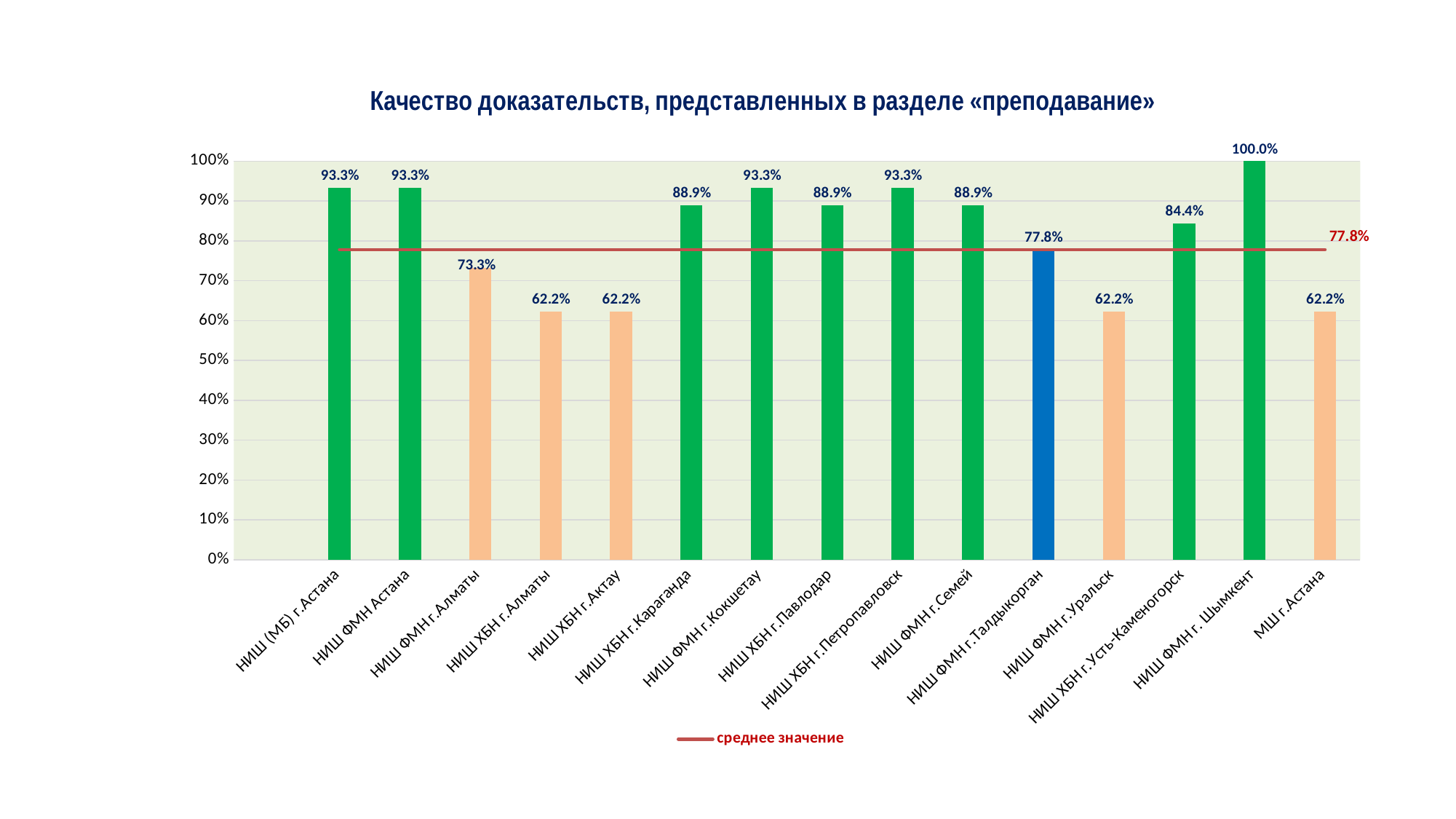
What is the value for НИШ ХБН г.Усть-Каменогорск? 84.4% What is the value for НИШ ФМН г.Талдыкорган? 77.8% How many categories are shown on the x axis? 15 Which category has the highest value? НИШ ФМН г. Шымкент What kind of chart is shown on the slide? bar chart What is the difference between the values for НИШ ХБН г.Караганда and НИШ ХБН г.Алматы? 26.7% What is the difference between the values for НИШ ФМН г. Шымкент and НИШ ХБН г.Усть-Каменогорск? 15.6% Is the value for НИШ ФМН г.Уральск greater or less than 70%? less What is the value for НИШ ФМН г.Алматы? 73.3% What is the value for НИШ ФМН г. Шымкент? 100.0% What value is shown for the red average line (среднее значение)? 77.8% Which is larger, the value for НИШ ФМН г.Кокшетау or the value for НИШ ФМН г.Семей? НИШ ФМН г.Кокшетау